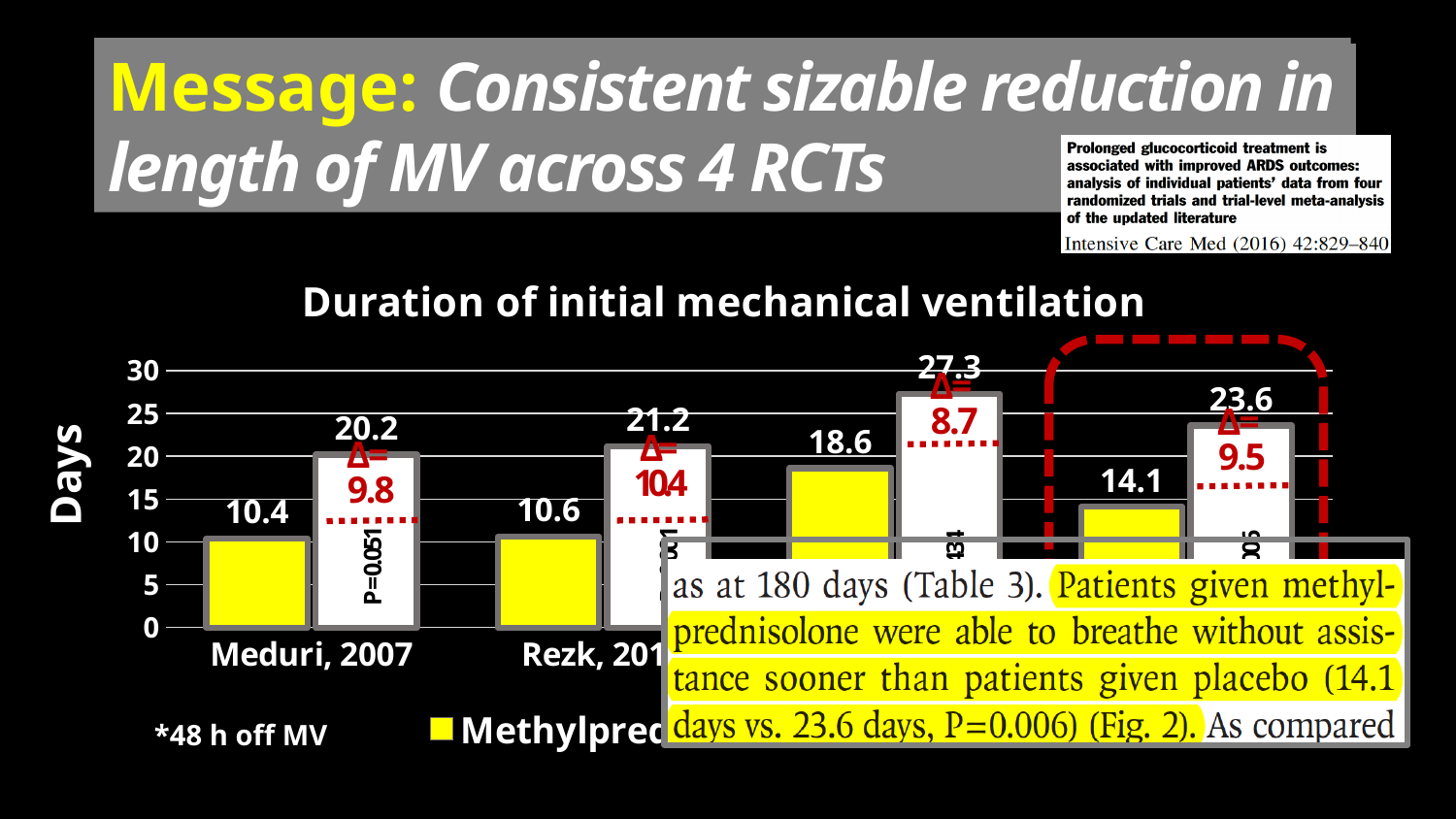
What is the label on the vertical axis of the chart? Days What is the lowest value labelled on any bar in the chart? 10.4 What is the highest value labelled on any bar in the chart? 27.3 How many study groups are plotted along the x axis of the chart? 4 What is the title of the chart? Duration of initial mechanical ventilation What is the difference between the white bar (23.6) and the yellow bar (14.1) in the rightmost group? 9.5 Which bar is taller for Meduri, 2007, the yellow bar or the white bar? the white bar What is the value of the yellow bar for Meduri, 2007? 10.4 What is the difference between the white bar and the yellow bar for Meduri, 2007? 9.8 What kind of chart is shown on the slide? bar chart What is the value of the yellow bar in the rightmost group of the chart? 14.1 What is the value of the white bar for Meduri, 2007? 20.2